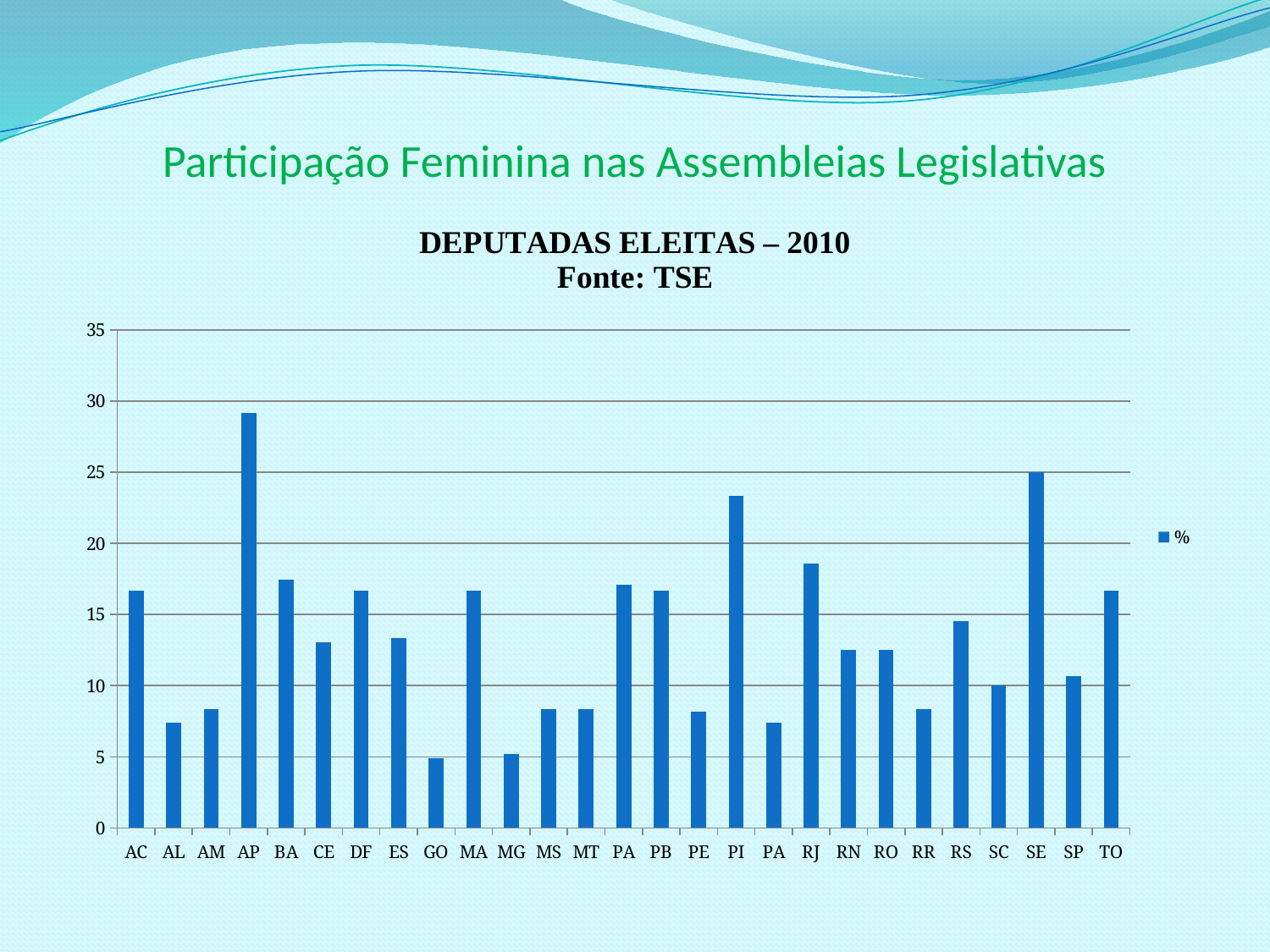
What source is cited for the chart's data? TSE Is the value for GO greater or less than 10? less Which category has the highest value in the chart? AP Is the value for BA greater or less than 15? greater Which is larger, the value for AP or the value for SE? AP How many categories are shown on the x axis of the chart? 27 Is the value for PI greater or less than 20? greater What kind of chart is shown on the slide? bar chart What is the legend entry shown for the series in the chart? % Which is larger, the value for PI or the value for RJ? PI How many series does the chart's legend list? 1